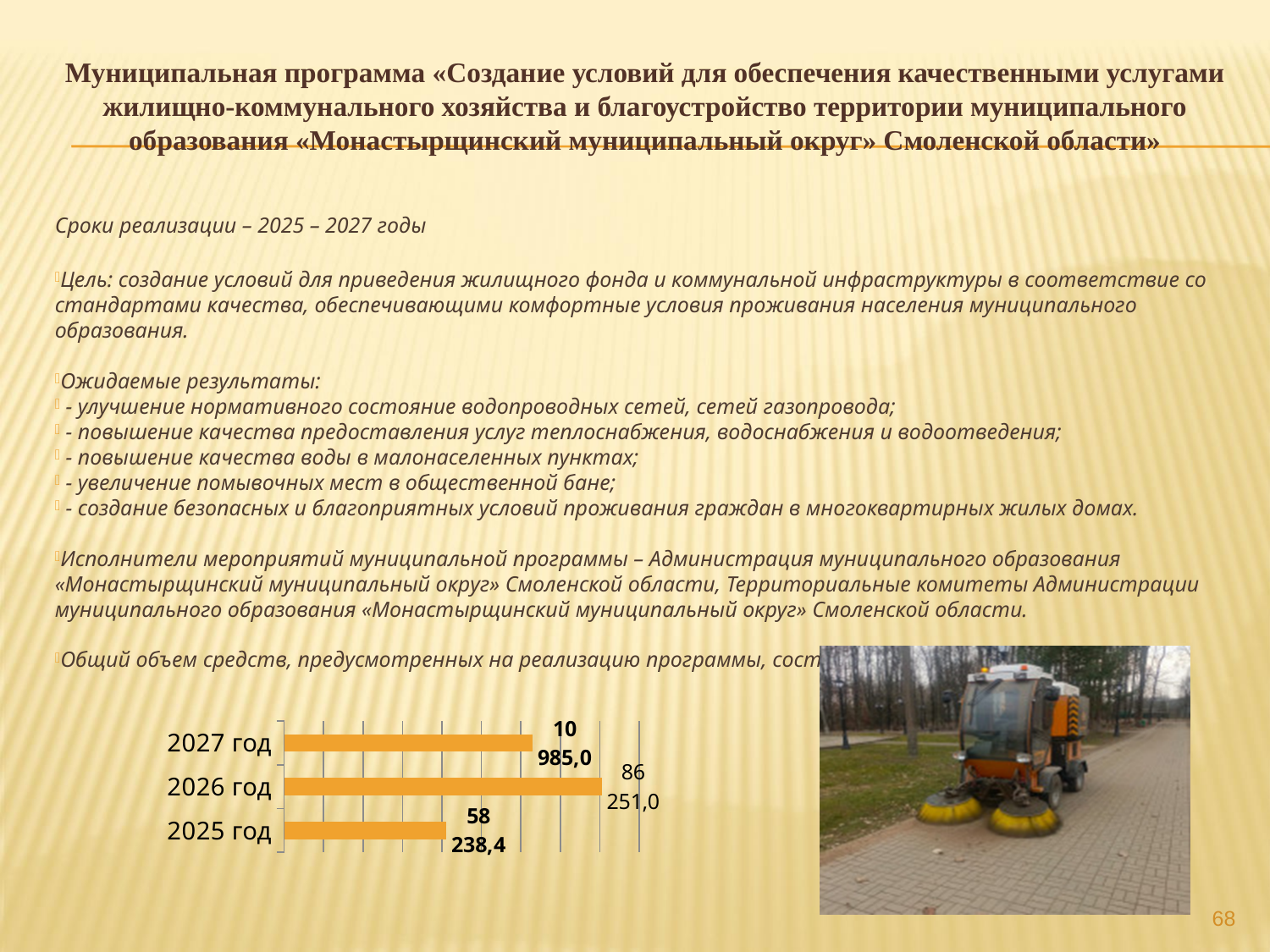
What kind of chart is shown on the slide? bar chart What is the difference between the values for 2026 год and 2025 год? 28 012,6 What is the value for 2026 год in the chart? 86 251,0 Which category is listed at the bottom of the chart? 2025 год Which is larger, the value for 2025 год or for 2026 год? 2026 год What colour are the bars in the chart? orange How many categories (years) does the chart show? 3 What is the value for 2025 год in the chart? 58 238,4 Which year has the highest value in the chart? 2026 год